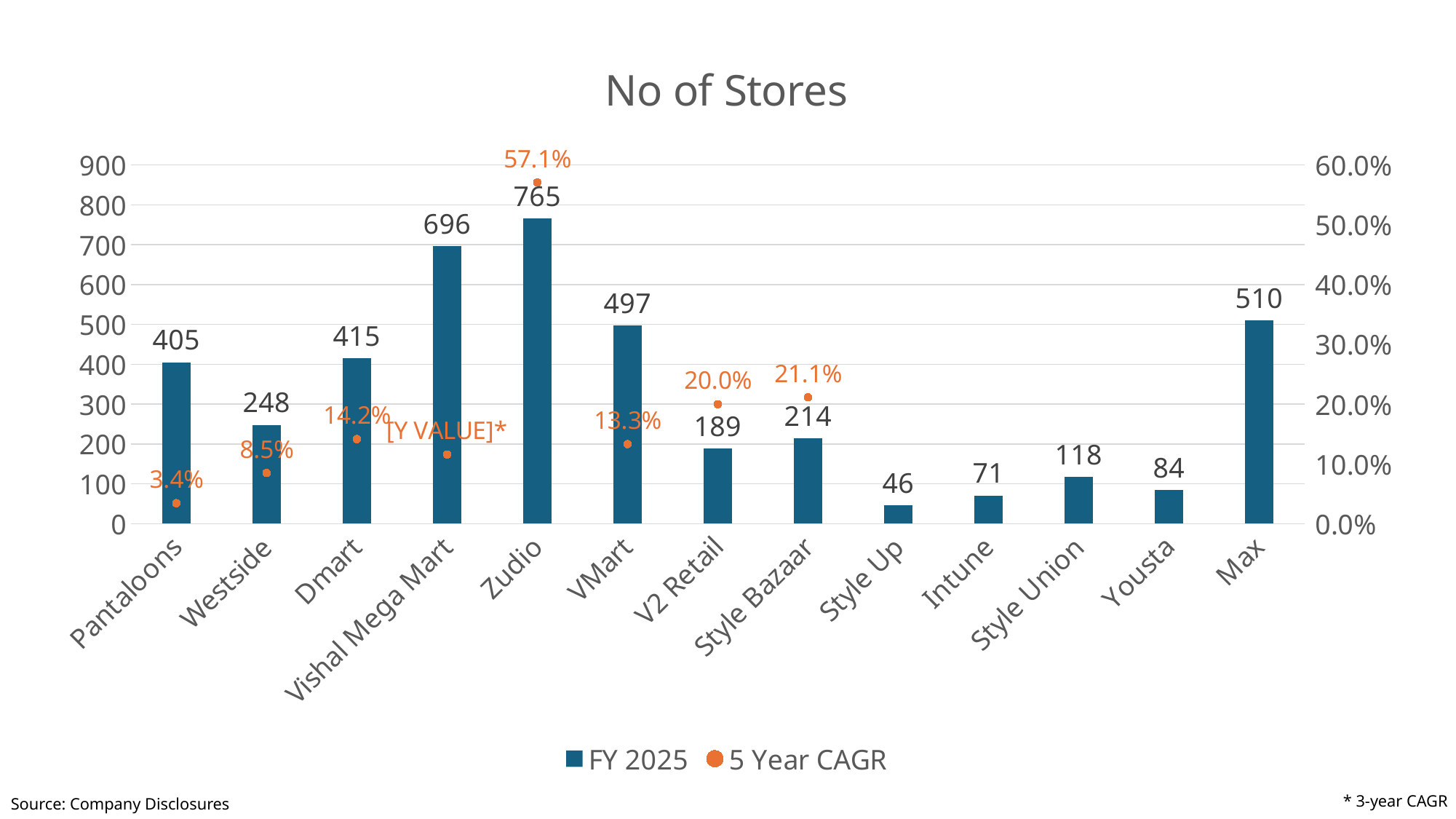
What is the FY 2025 number of stores for Zudio? 765 What is the FY 2025 number of stores for Vishal Mega Mart? 696 What is the title of the chart? No of Stores Which retailer has the lowest FY 2025 number of stores? Style Up Which has more FY 2025 stores, Dmart or Pantaloons? Dmart How many retailers are shown on the x axis? 13 What is the 5 Year CAGR shown for V2 Retail? 20.0% Which retailer has the highest 5 Year CAGR? Zudio How many series does the legend list? 2 What is the difference in FY 2025 store count between Max and VMart? 13 What is the 5 Year CAGR shown for Pantaloons? 3.4% Which retailer has the highest FY 2025 number of stores? Zudio